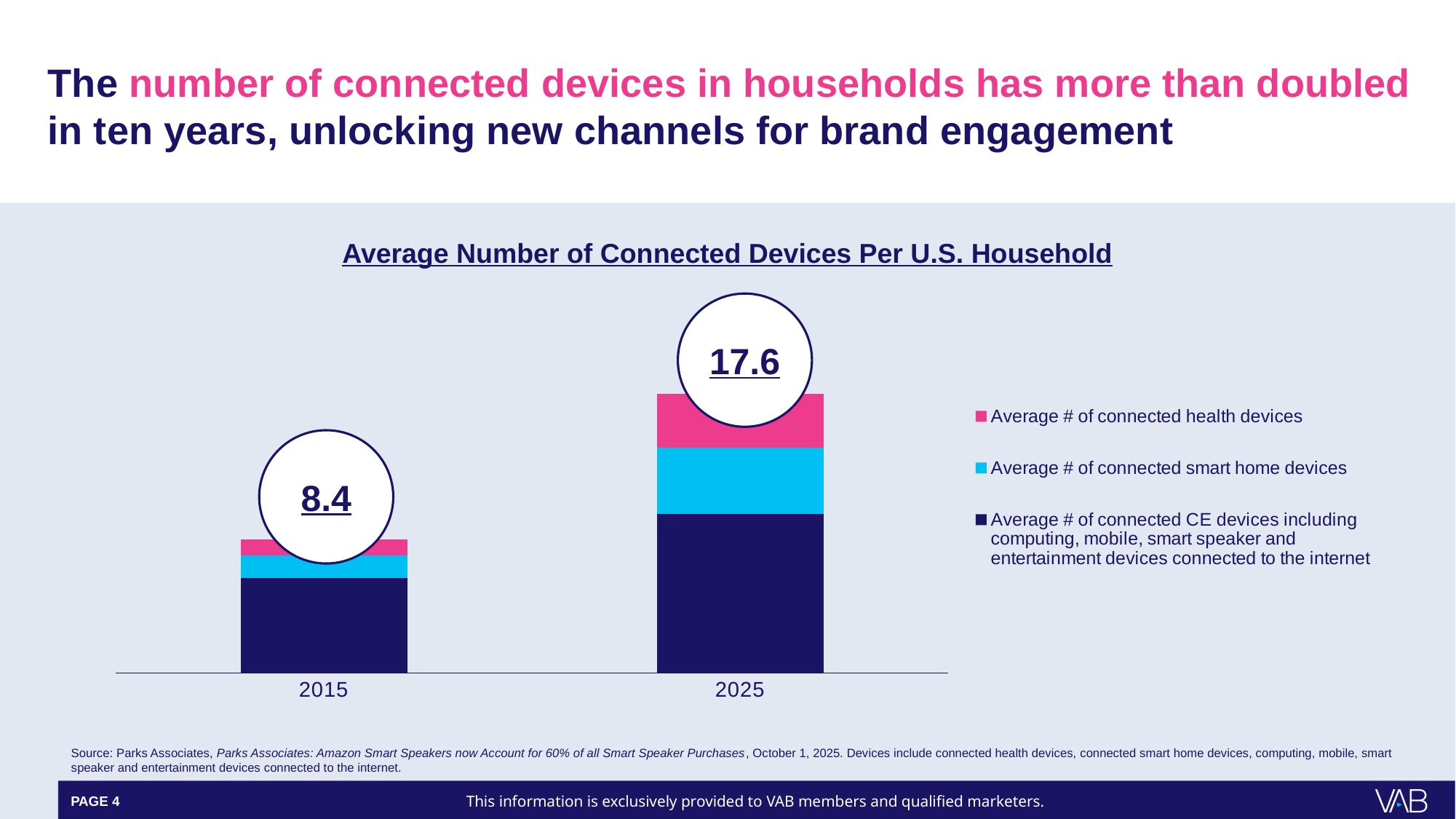
Do the totals rise or fall from 2015 to 2025? rise How many years are shown on the x axis of the chart? 2 By how much does the average number of connected devices per household in 2025 exceed that of 2015? 9.2 What is the average number of connected devices per U.S. household in 2015? 8.4 What kind of chart is shown on the slide? stacked bar chart How many series does the chart legend list? 3 What is the average number of connected devices per U.S. household in 2025? 17.6 Is the total for 2025 larger or smaller than the total for 2015? larger Which year has the lower average number of connected devices per household? 2015 What is the title of the chart? Average Number of Connected Devices Per U.S. Household Which year has the higher average number of connected devices per household? 2025 Which series makes up the largest portion of the 2025 stacked bar? Average # of connected CE devices including computing, mobile, smart speaker and entertainment devices connected to the internet